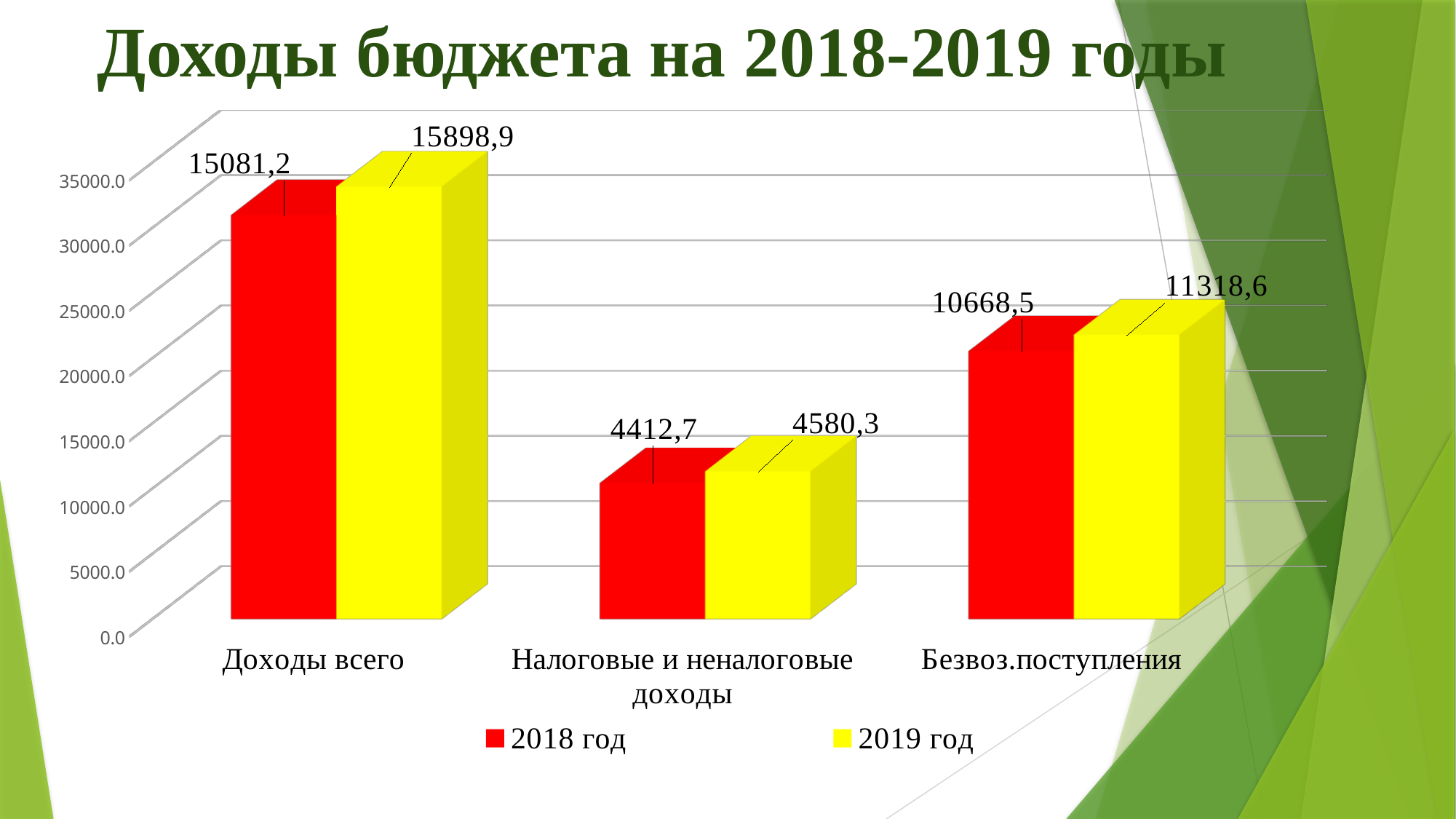
What is the difference between the 2019 год and 2018 год values for Безвоз.поступления? 650,1 How many categories are shown on the x axis? 3 What type of chart is shown on the slide? Bar chart Which category has the highest value in the 2019 год series? Доходы всего What is the difference between the 2019 год and 2018 год values for Доходы всего? 817,7 What is the value for Налоговые и неналоговые доходы in the 2018 год series? 4412,7 Which category has the lowest value in the 2018 год series? Налоговые и неналоговые доходы What is the value for Доходы всего in the 2019 год series? 15898,9 What is the value for Доходы всего in the 2018 год series? 15081,2 How many series does the legend list? 2 Which is larger for Налоговые и неналоговые доходы: the 2018 год value or the 2019 год value? 2019 год What is the value for Безвоз.поступления in the 2019 год series? 11318,6